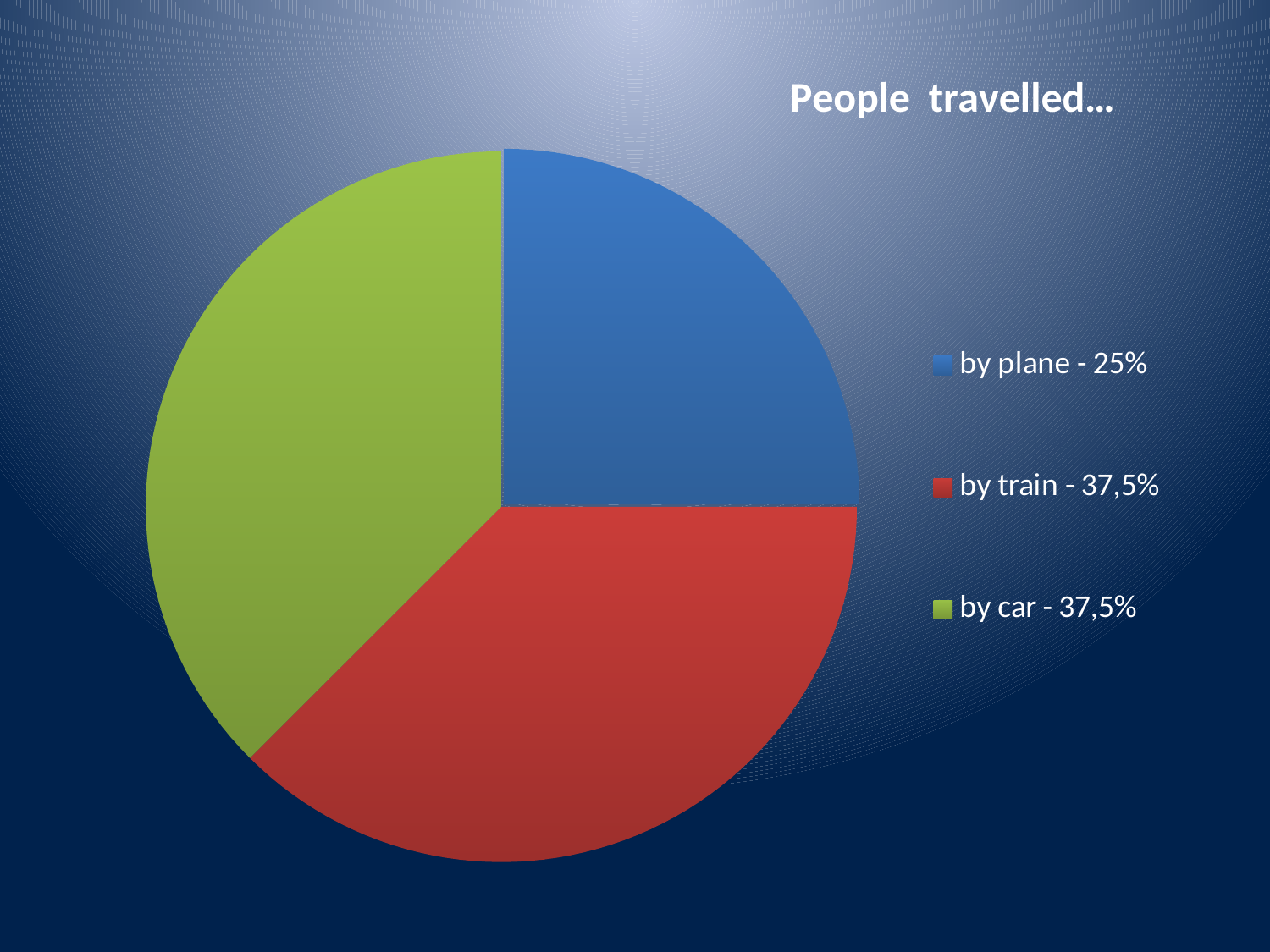
What is the title of the chart? People travelled... What share of people travelled by plane? 25% Which category has the smallest share of the pie? by plane Which colour represents the by plane slice? blue How many categories does the pie chart show? 3 What kind of chart is shown on the slide? pie chart Which is larger, the share for by train or the share for by plane? by train Is the share for by plane greater or less than 30%? less Is the share for by car greater or less than 30%? greater What share of people travelled by train? 37,5% What share of people travelled by car? 37,5% What is the difference between the share for by train and the share for by plane? 12,5%